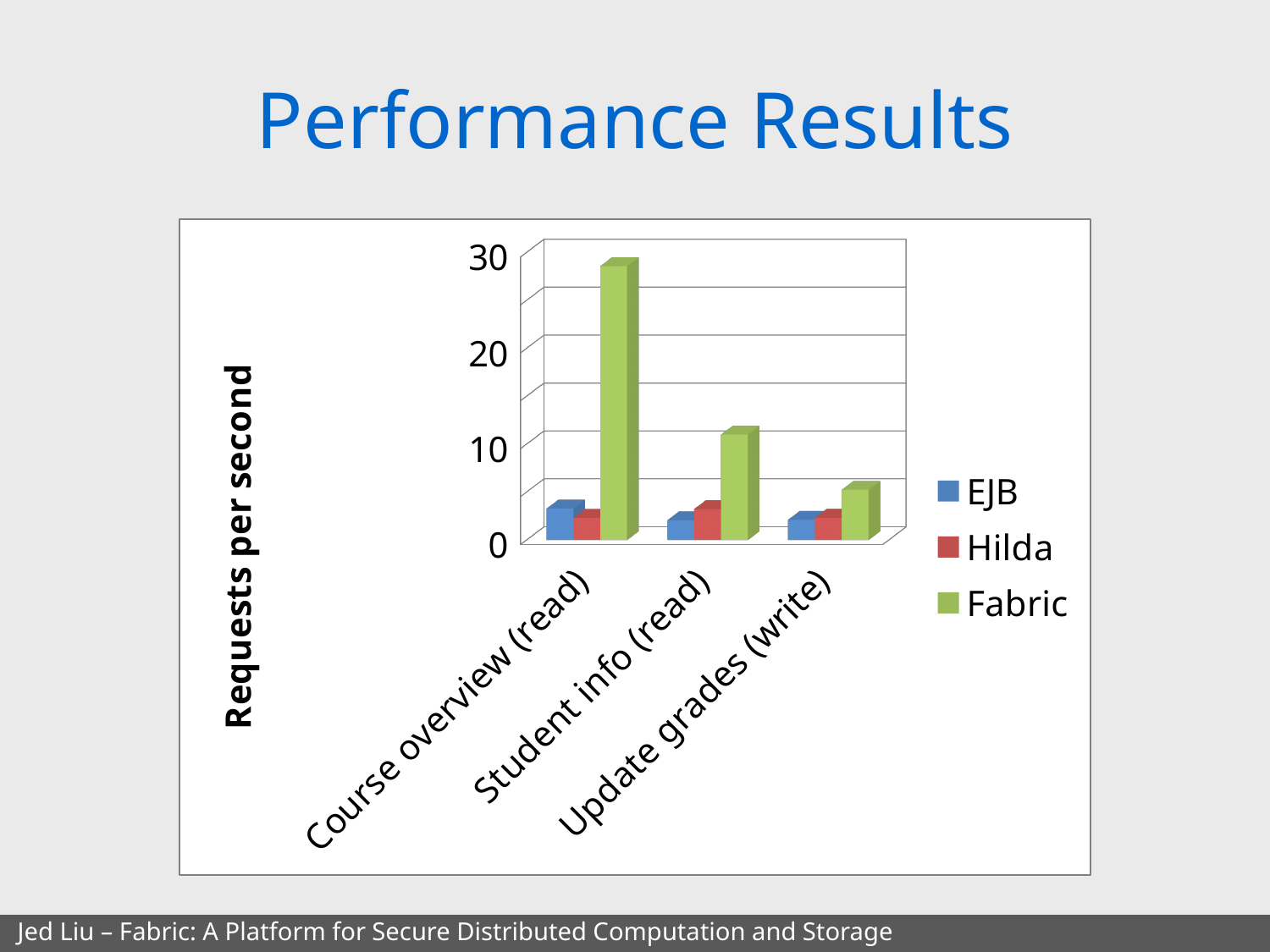
Is the value for EJB in Course overview (read) greater or less than 10? less Which series has the highest value for Course overview (read)? Fabric What kind of chart is shown on the slide? bar chart Is the value for Fabric in Course overview (read) greater or less than 20? greater Is the value for Fabric in Student info (read) greater or less than 20? less Which series are listed in the chart's legend? EJB, Hilda, Fabric How many categories are shown on the x axis of the chart? 3 For which category does Fabric have its lowest value? Update grades (write) What is the label of the vertical axis of the chart? Requests per second For which category does Fabric have its highest value? Course overview (read) Do the Fabric values rise or fall from Course overview (read) to Update grades (write)? fall How many series does the chart's legend list? 3